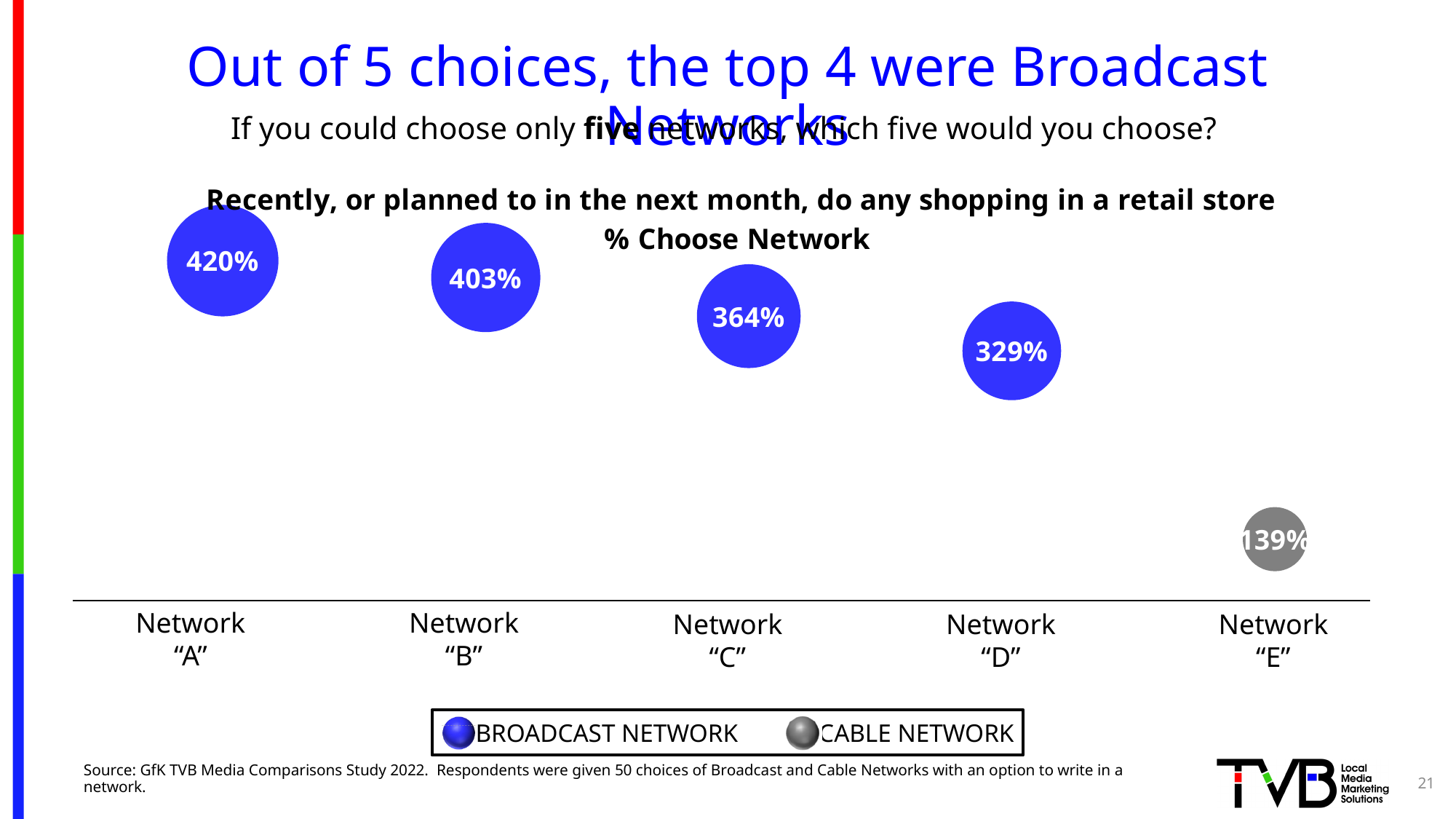
What is the difference between the values for Network "A" and Network "B"? 17% How many networks are shown on the chart? 5 Which legend entry is shown in grey? CABLE NETWORK What is the difference between the values for Network "D" and Network "E"? 190% What is the value for Network "A"? 420% What is the value for Network "E"? 139% What is the value for Network "C"? 364% Which network has the lowest value? Network "E" Which is larger, the value for Network "B" or Network "D"? Network "B" Do the values rise or fall from Network "A" to Network "E"? fall Which network has the highest value? Network "A" How many series does the legend list? 2